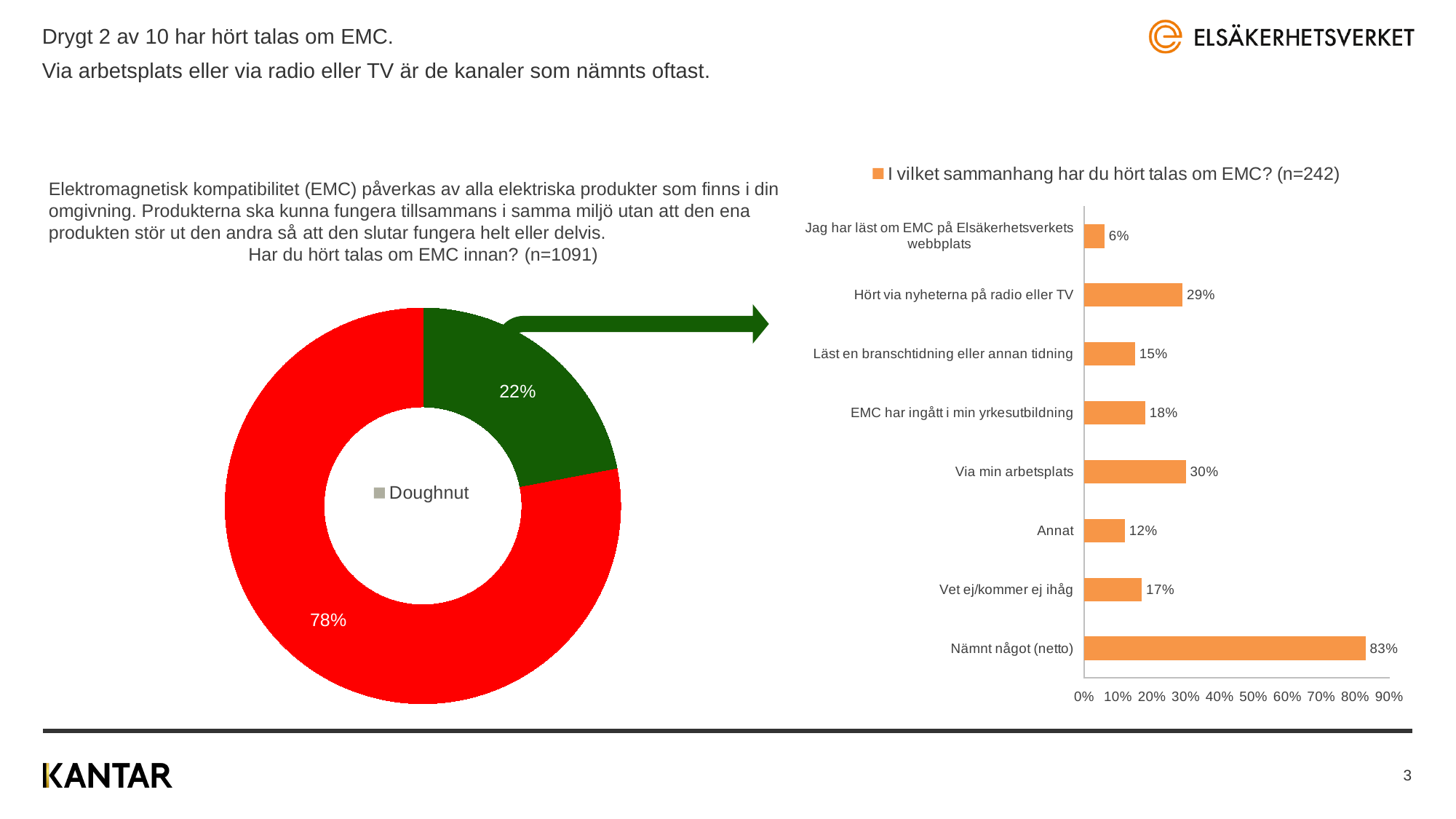
In the doughnut chart 'Har du hört talas om EMC innan? (n=1091)', what share does the green slice represent? 22% In the bar chart 'I vilket sammanhang har du hört talas om EMC? (n=242)', which category has the highest value? Nämnt något (netto) In the bar chart 'I vilket sammanhang har du hört talas om EMC? (n=242)', which category has the lowest value? Jag har läst om EMC på Elsäkerhetsverkets webbplats In the bar chart 'I vilket sammanhang har du hört talas om EMC? (n=242)', what is the value for 'Hört via nyheterna på radio eller TV'? 29% In the bar chart 'I vilket sammanhang har du hört talas om EMC? (n=242)', what is the value for 'Jag har läst om EMC på Elsäkerhetsverkets webbplats'? 6% In the bar chart 'I vilket sammanhang har du hört talas om EMC? (n=242)', which is larger: 'EMC har ingått i min yrkesutbildning' or 'Annat'? EMC har ingått i min yrkesutbildning What kind of chart is the chart on the right of the slide, 'I vilket sammanhang har du hört talas om EMC? (n=242)'? Bar chart In the bar chart 'I vilket sammanhang har du hört talas om EMC? (n=242)', what is the difference between 'Nämnt något (netto)' and 'Via min arbetsplats'? 53% In the bar chart 'I vilket sammanhang har du hört talas om EMC? (n=242)', how many categories are shown? 8 In the doughnut chart 'Har du hört talas om EMC innan? (n=1091)', what share does the red slice represent? 78% What kind of chart is the chart on the left of the slide, 'Har du hört talas om EMC innan? (n=1091)'? Doughnut chart In the bar chart 'I vilket sammanhang har du hört talas om EMC? (n=242)', what is the value for 'Via min arbetsplats'? 30%